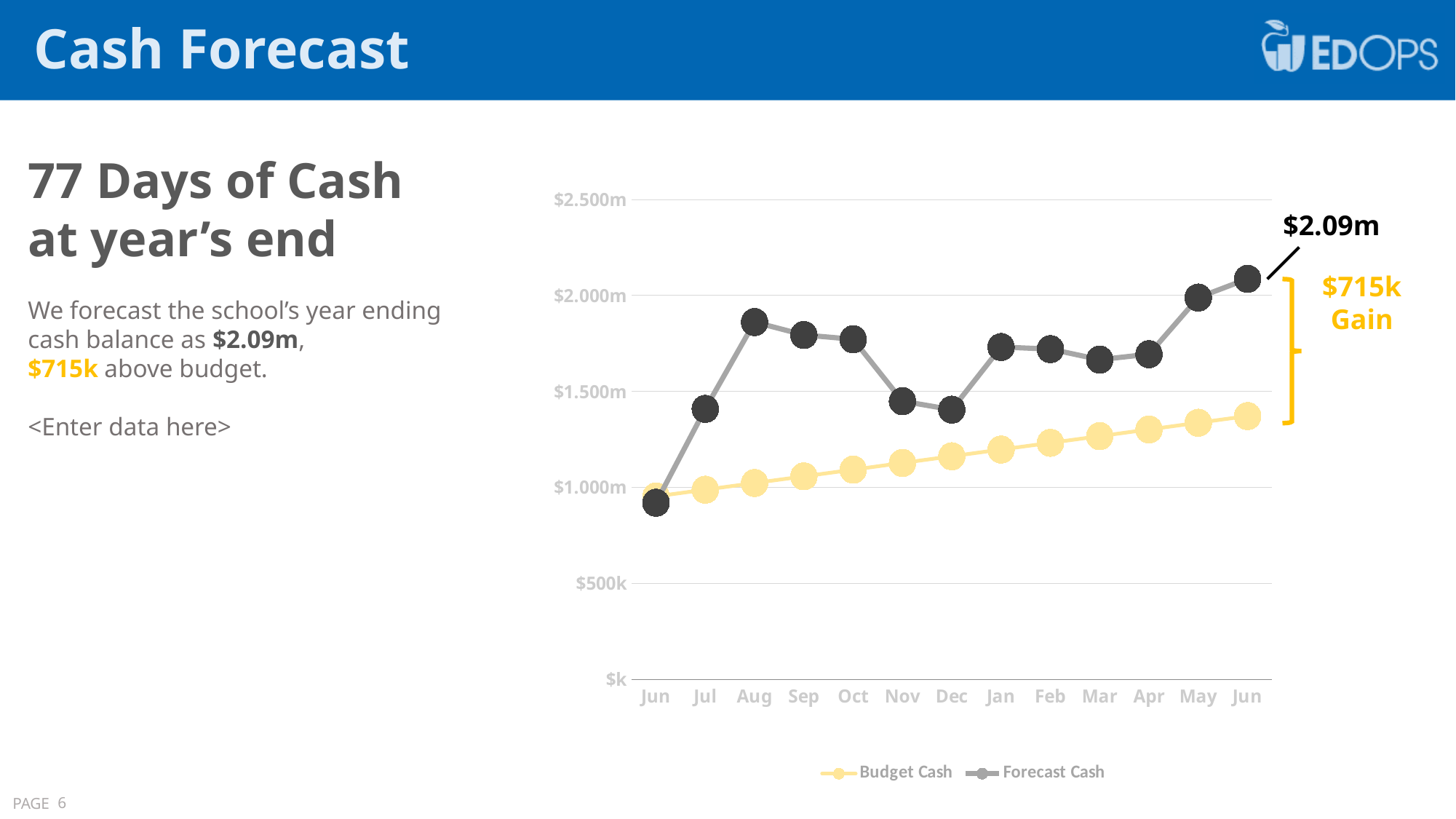
Does the Budget Cash series rise or fall from the first Jun to the final Jun? rise Is the Budget Cash value for the final Jun greater or less than $1.500m? less In which month does Forecast Cash reach its highest value? Jun (final) Is the Forecast Cash value for Dec greater or less than $1.500m? less In which month is Forecast Cash at its lowest value? Jun (first) How many months are plotted along the x axis of the chart? 13 In Jan, which series has the higher value, Budget Cash or Forecast Cash? Forecast Cash What gain does the annotation beside the chart show between Forecast Cash and Budget Cash at year end? $715k How many series does the chart legend list? 2 What is the Forecast Cash value at the final Jun on the chart? $2.09m What kind of chart is shown on the slide? line chart Is the Forecast Cash value for Aug greater or less than $1.500m? greater